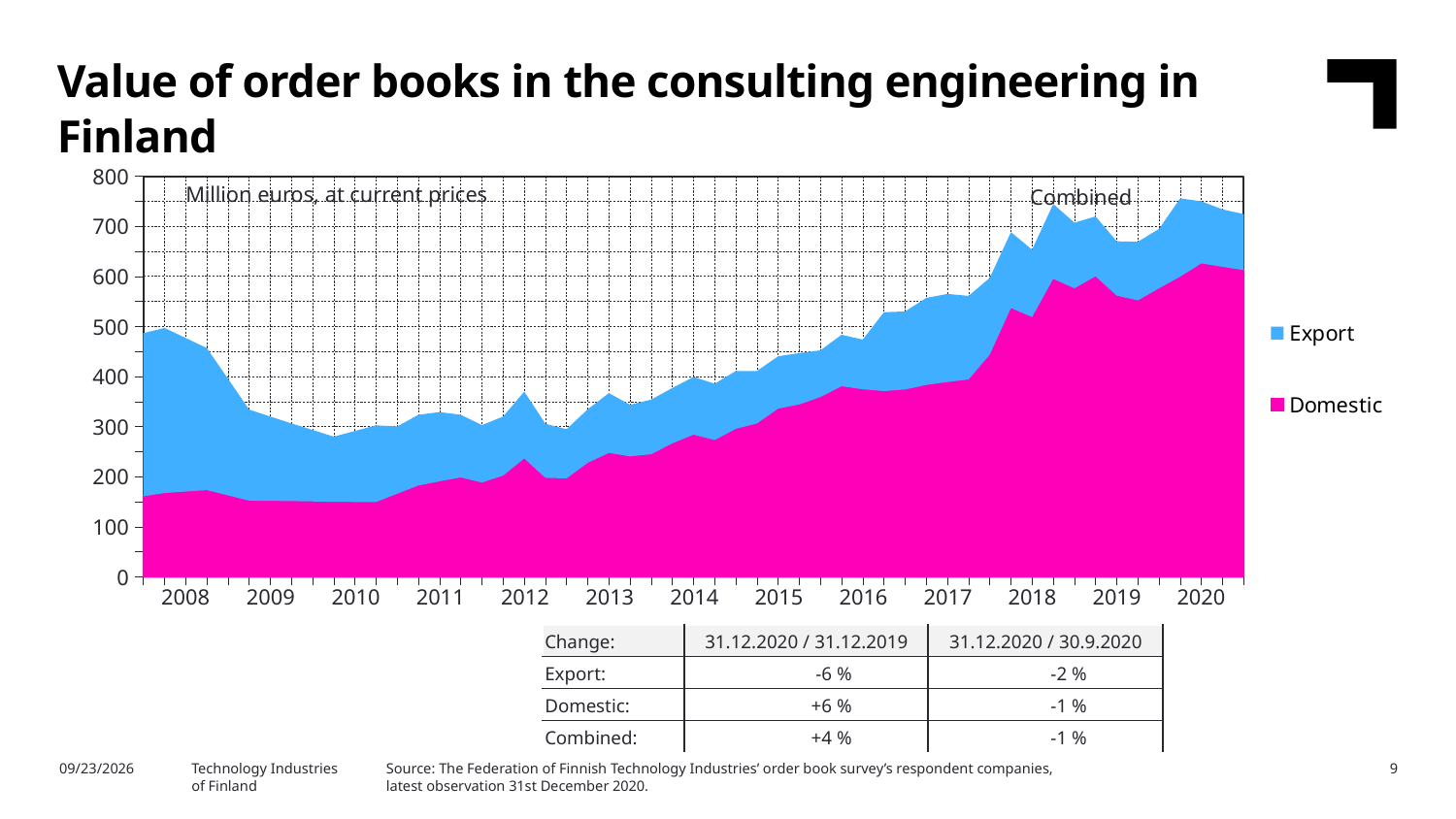
Is the Domestic value in 2010 greater or less than 200? less Does the Domestic value rise or fall between 2010 and 2020? rise Which two series are listed in the chart legend? Export and Domestic What unit is stated for the values in the chart? Million euros, at current prices Is the combined value of order books in 2010 greater or less than 400? less Is the peak combined value in 2018 greater or less than 700? greater How many series does the legend list? 2 Does the combined value rise or fall between 2008 and 2010? fall What kind of chart is shown on the slide? Stacked area chart